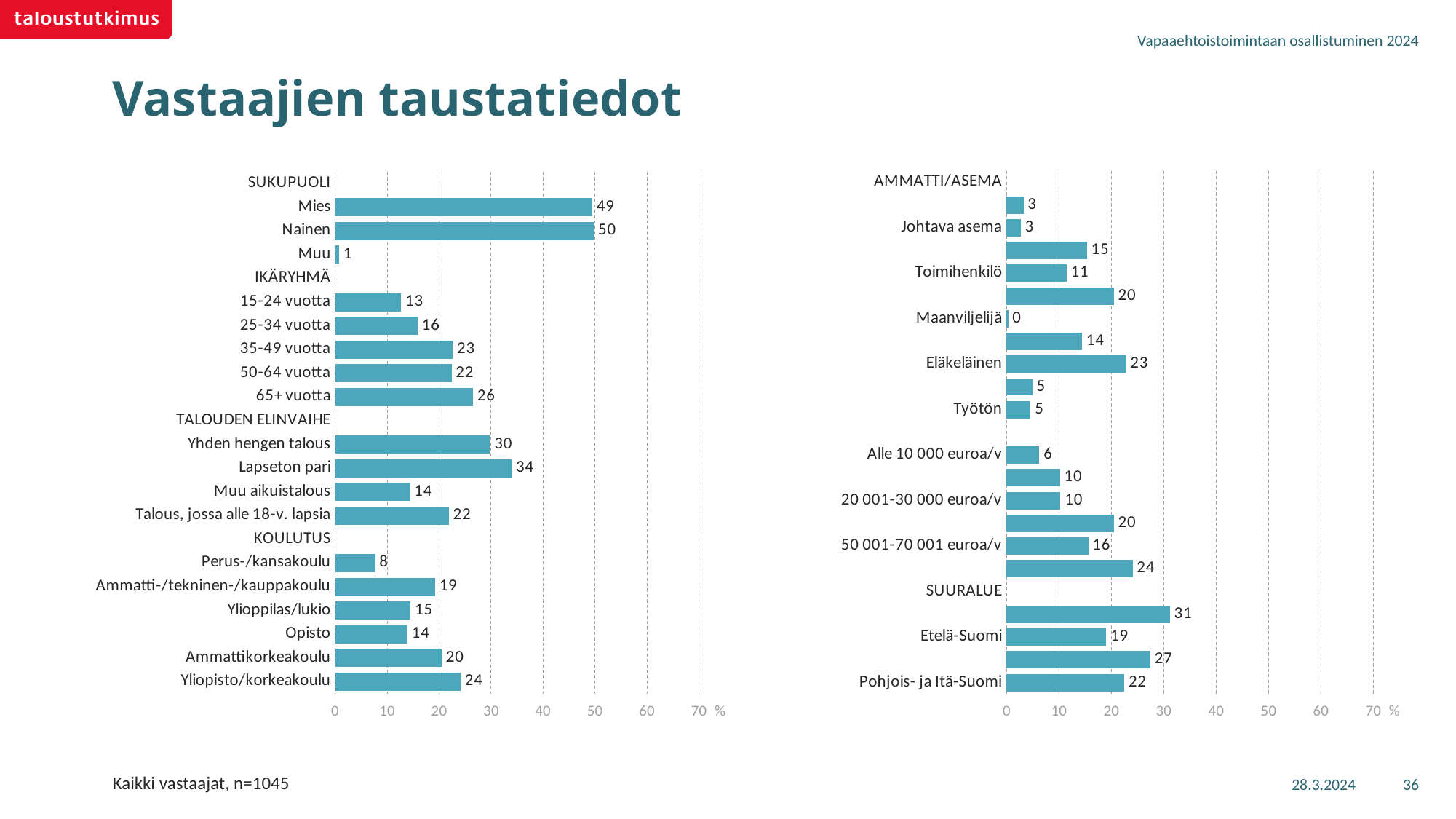
In the left chart, is the value for Mies greater or less than 40? greater In the left chart, what is the value for 65+ vuotta? 26 In the left chart, what is the value for Nainen? 50 What type of chart is shown on the left of the slide? Bar chart In the right chart, what is the value for Eläkeläinen? 23 In the right chart, what is the difference between Pohjois- ja Itä-Suomi and Etelä-Suomi? 3 In the left chart, which is larger: Ammattikorkeakoulu or Ylioppilas/lukio? Ammattikorkeakoulu In the left chart, what is the difference between Lapseton pari and Yhden hengen talous? 4 In the left chart, which education category (KOULUTUS) has the highest value? Yliopisto/korkeakoulu In the right chart, what is the value for Maanviljelijä? 0 In the right chart, which is larger: Toimihenkilö or Työtön? Toimihenkilö In the left chart, which age group (IKÄRYHMÄ) has the lowest value? 15-24 vuotta